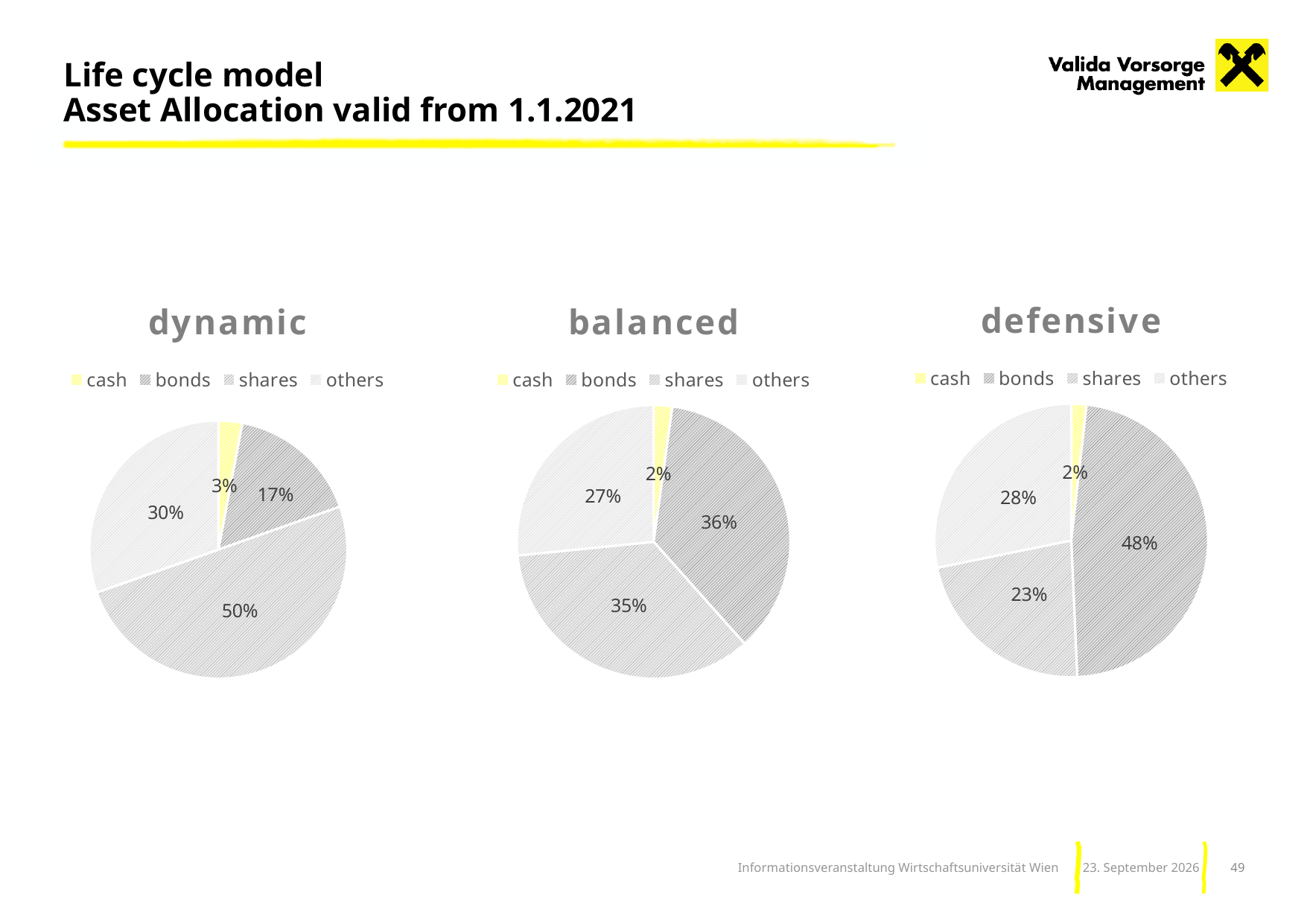
In the 'dynamic' pie chart, which category has the largest slice? shares In the 'dynamic' pie chart, what is the difference between the shares slice and the others slice? 20% How many pie charts are shown on the slide? 3 In the 'defensive' pie chart, which category has the smallest slice? cash In the 'dynamic' pie chart, what share is labelled for cash? 3% In the 'defensive' pie chart, what share is labelled for bonds? 48% In the 'defensive' pie chart, which is larger, the others slice or the shares slice? others What type of chart is used for the 'balanced' asset allocation? pie chart In the 'dynamic' pie chart, what share is labelled for shares? 50% In the 'defensive' pie chart, what share is labelled for shares? 23% In the 'balanced' pie chart, what share is labelled for bonds? 36% How many categories does the legend of the 'balanced' pie chart list? 4